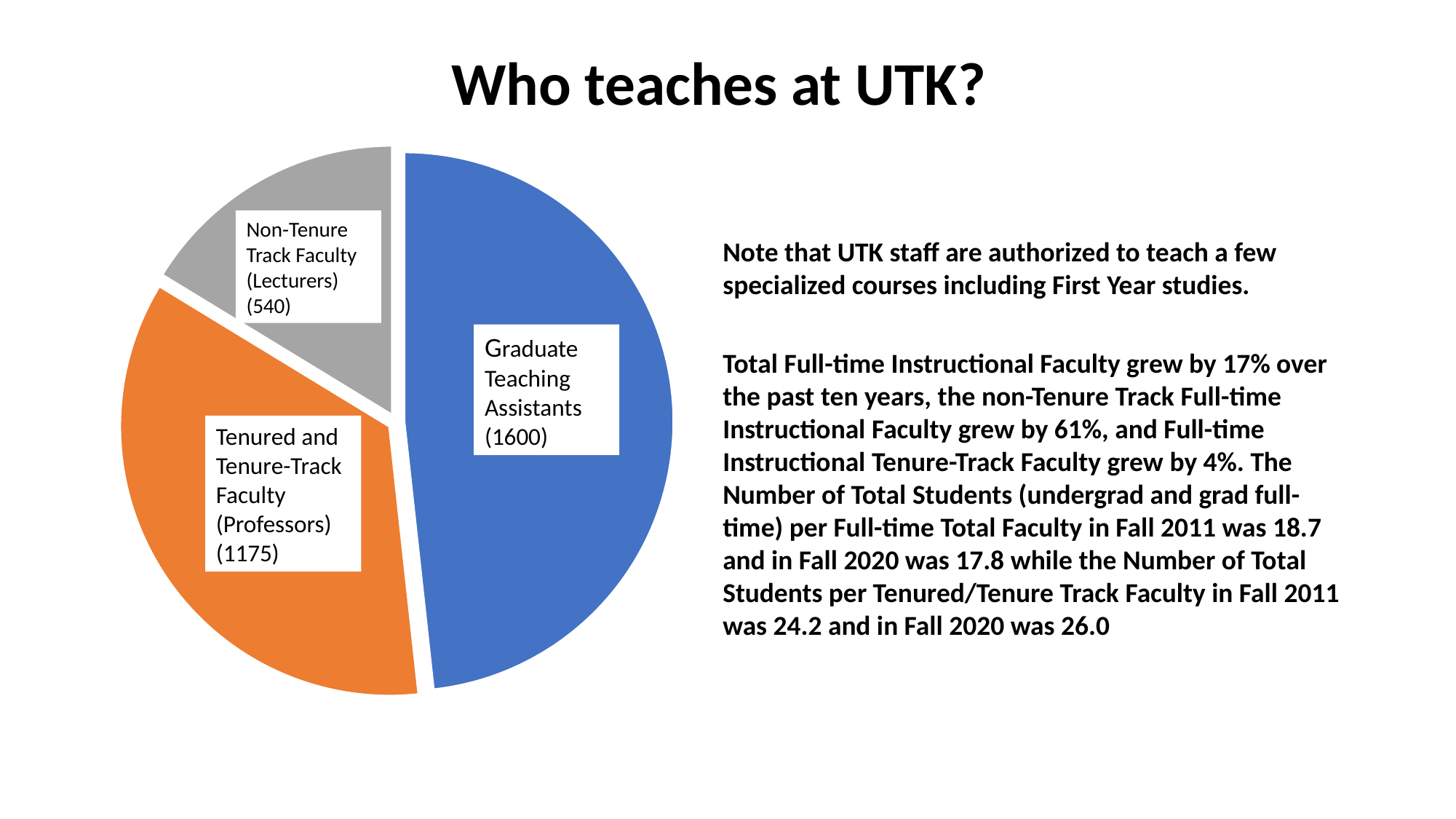
Which category has the smallest slice of the pie? Non-Tenure Track Faculty (Lecturers) What is the value shown for Non-Tenure Track Faculty (Lecturers)? 540 What is the difference between the Tenured and Tenure-Track Faculty value and the Non-Tenure Track Faculty value? 635 What type of chart is shown on the slide? Pie chart Which is larger: the value for Tenured and Tenure-Track Faculty or the value for Non-Tenure Track Faculty? Tenured and Tenure-Track Faculty Which category has the largest slice of the pie? Graduate Teaching Assistants What is the difference between the Graduate Teaching Assistants value and the Tenured and Tenure-Track Faculty value? 425 How many slices does the pie chart have? 3 What is the title of the slide containing the pie chart? Who teaches at UTK? What is the value shown for Tenured and Tenure-Track Faculty (Professors)? 1175 What is the total of all three slices in the pie chart? 3315 What is the value shown for Graduate Teaching Assistants? 1600